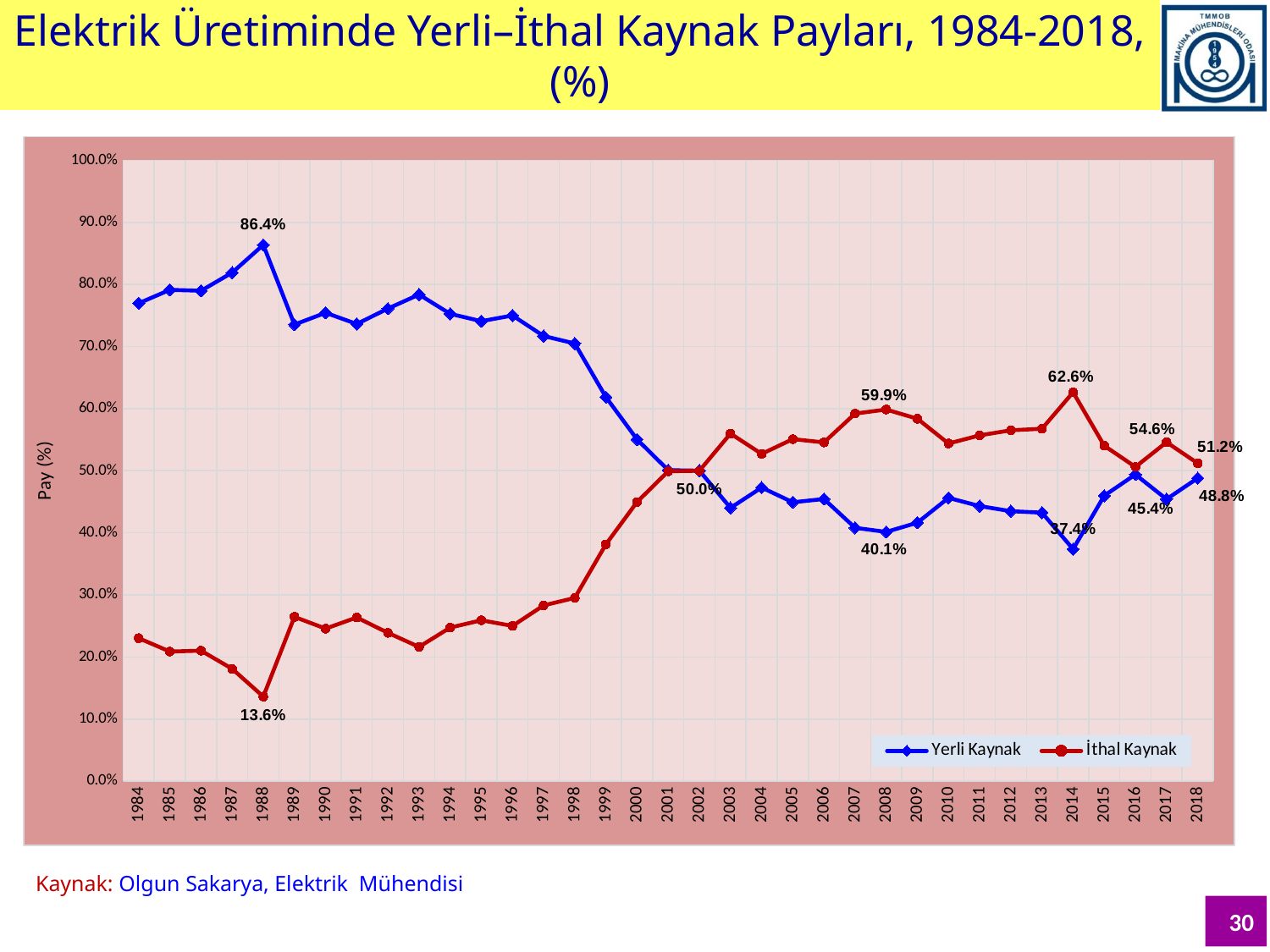
How many series does the legend list? 2 What is the value for İthal Kaynak in 1988? 13.6% What type of chart is shown on the slide? line chart Does the Yerli Kaynak series generally rise or fall from 1984 to 2018? fall What is the value for Yerli Kaynak in 1988? 86.4% In which year does the İthal Kaynak series reach its lowest value? 1988 What is the value for İthal Kaynak in 2014? 62.6% Is the value for Yerli Kaynak in 1984 greater or less than 70.0%? greater What is the value for Yerli Kaynak in 2018? 48.8% What is the difference between the İthal Kaynak and Yerli Kaynak values in 2014? 25.2% Which series has the larger value in 2008, Yerli Kaynak or İthal Kaynak? İthal Kaynak In which year does the Yerli Kaynak series reach its highest value? 1988